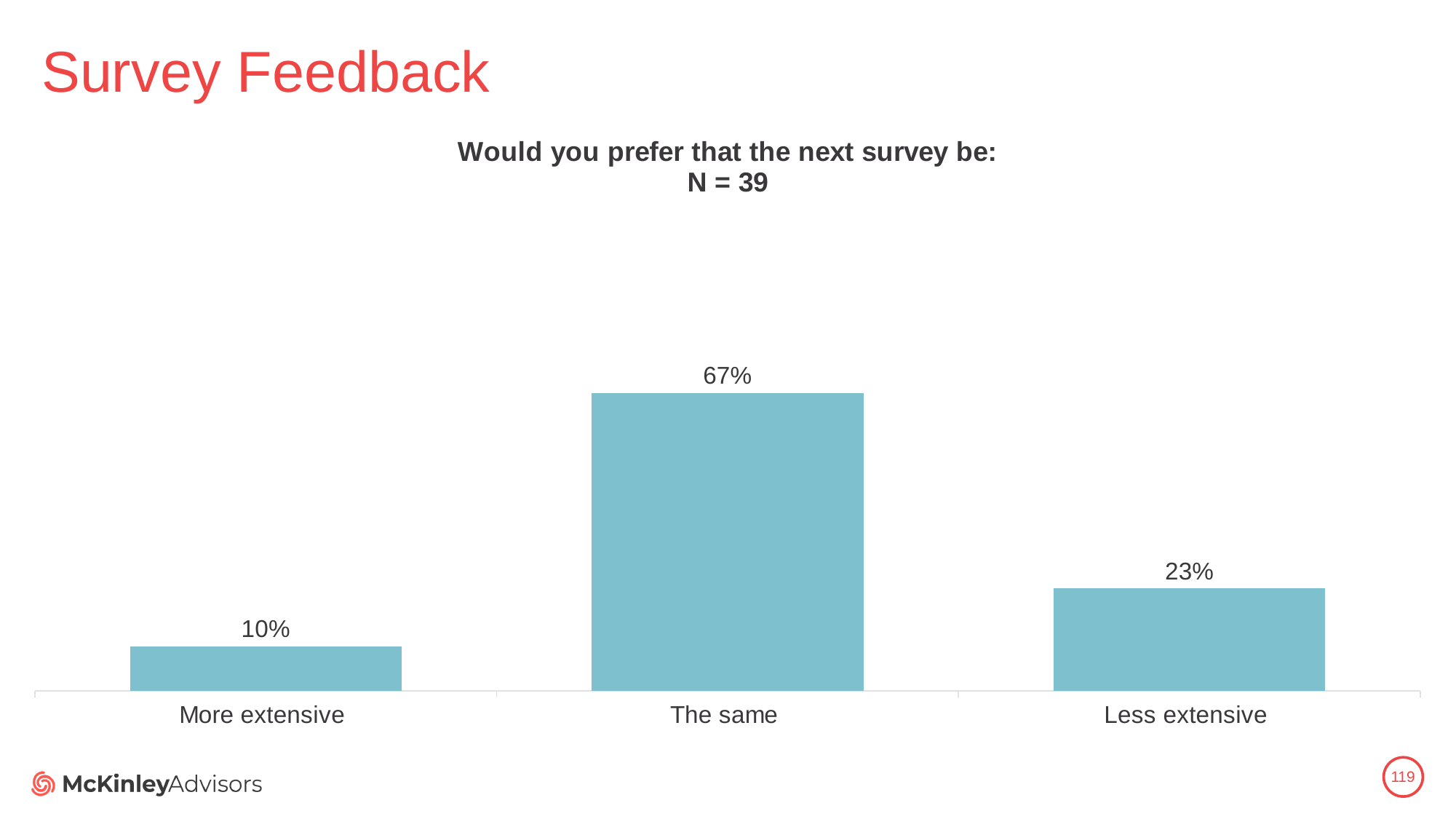
How many response categories are shown in the chart? 3 Which is larger: the percentage for "Less extensive" or for "More extensive"? Less extensive What is the difference in percentage points between "Less extensive" and "More extensive"? 13 What percentage of respondents preferred that the next survey be "The same"? 67% What type of chart is shown on the slide? Bar chart What is the difference in percentage points between "The same" and "Less extensive"? 44 Which response option has the lowest percentage? More extensive What percentage of respondents preferred that the next survey be "Less extensive"? 23% Which response option has the highest percentage? The same What percentage of respondents preferred that the next survey be "More extensive"? 10% What question does the chart title say respondents were asked? Would you prefer that the next survey be: What is the sample size (N) stated in the chart title? 39